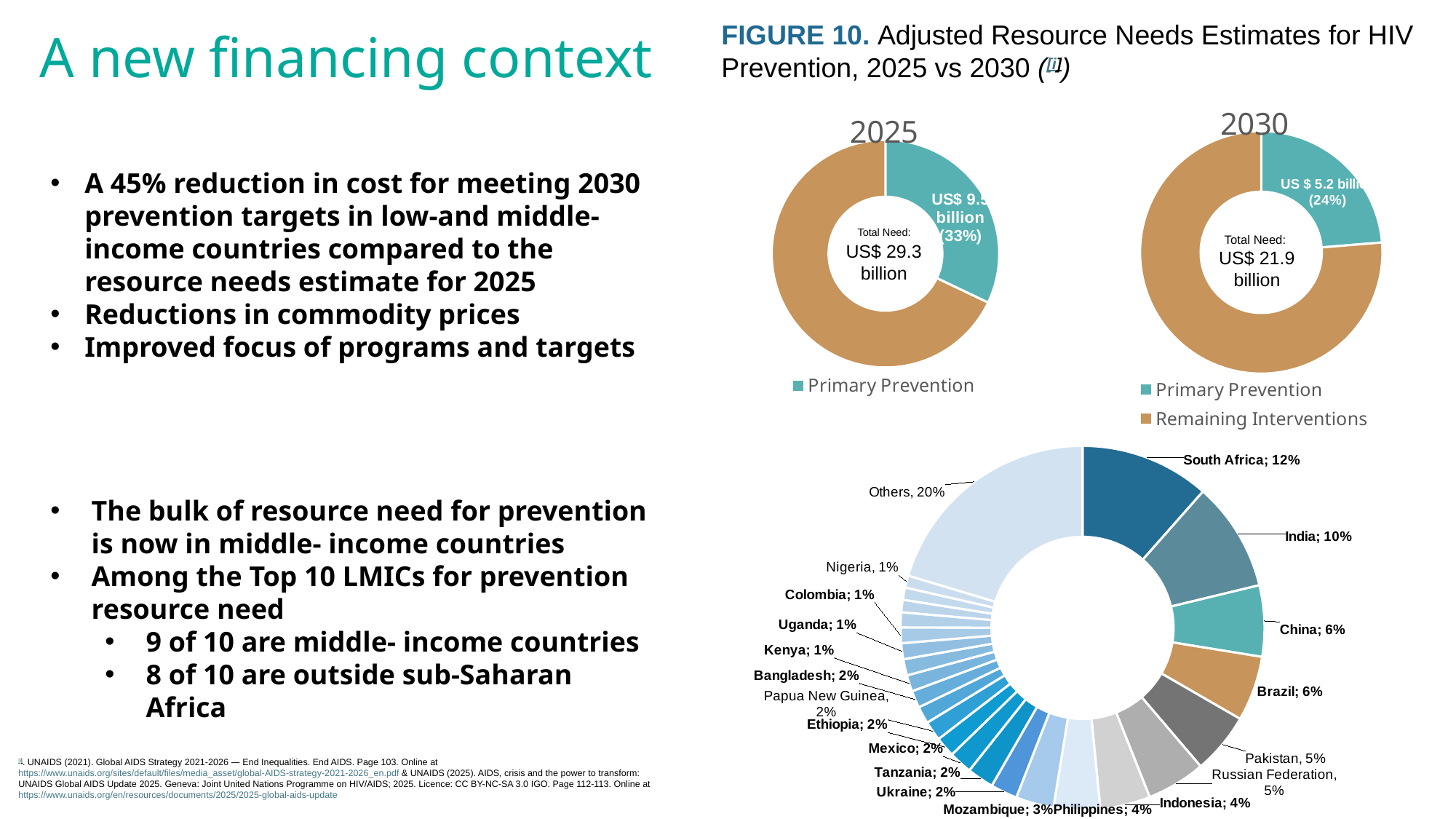
In the bottom country donut chart, which named country has the largest share? South Africa What kind of chart is used for the 2025 and 2030 figures? Donut (pie) chart In the 2025 donut chart, what is the total need shown in the centre? US$ 29.3 billion In the 2030 donut chart, what is the total need shown in the centre? US$ 21.9 billion In the 2025 donut chart, what percentage of the total is Primary Prevention? 33% How many series does the legend of the 2030 donut chart list? 2 In the bottom country donut chart, what is the share for Brazil? 6% In the 2030 donut chart, what is the value for Primary Prevention? US $ 5.2 billion In the 2030 donut chart, what percentage of the total is Primary Prevention? 24% In the bottom country donut chart, which has the larger share, India or China? India In the bottom country donut chart, what is the difference between the shares of South Africa and India? 2 percentage points In the bottom country donut chart, what is the share for South Africa? 12%